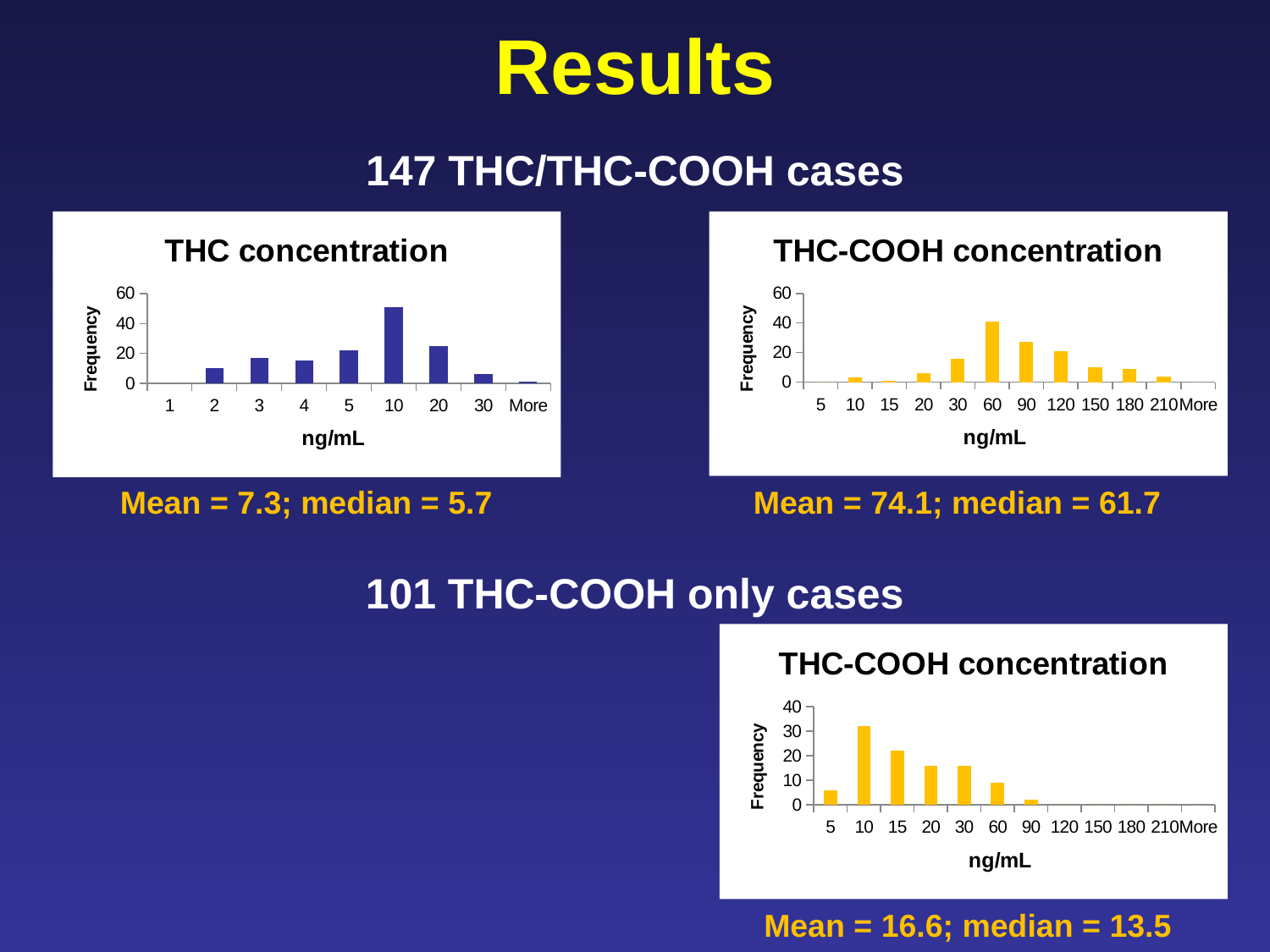
In the 'THC concentration' chart, which has the higher frequency, the 10 ng/mL category or the 20 ng/mL category? 10 In the bottom-right 'THC-COOH concentration' chart (101 THC-COOH only cases), is the frequency for the 5 ng/mL category greater or less than 10? less In the 'THC concentration' chart, is the frequency for the 2 ng/mL category greater or less than 20? less What is the x-axis label on the 'THC concentration' chart? ng/mL What kind of chart is the 'THC concentration' chart? bar chart In the bottom-right 'THC-COOH concentration' chart (101 THC-COOH only cases), which ng/mL category has the highest frequency? 10 In the top-right 'THC-COOH concentration' chart (147 THC/THC-COOH cases), how many categories are shown on the x axis? 12 In the 'THC concentration' chart, which ng/mL category has the highest frequency? 10 In the top-right 'THC-COOH concentration' chart (147 THC/THC-COOH cases), which ng/mL category has the highest frequency? 60 In the top-right 'THC-COOH concentration' chart (147 THC/THC-COOH cases), is the frequency for the 90 ng/mL category greater or less than 20? greater In the 'THC concentration' chart, how many categories are shown on the x axis? 9